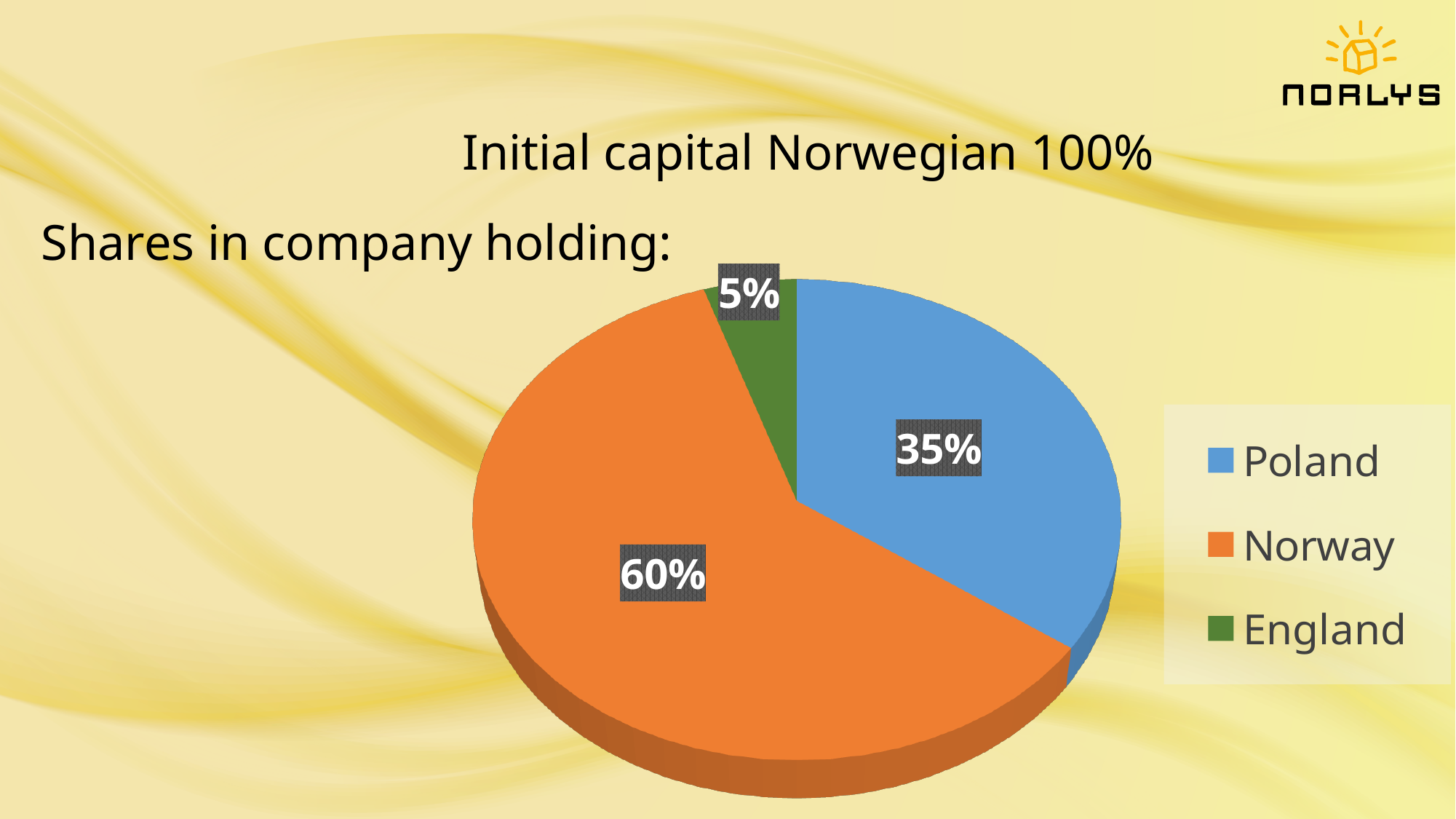
What share of the company holding does Poland have? 35% What share of the company holding does Norway have? 60% Which country holds the largest share in the company holding? Norway What colour represents Norway in the pie chart? Orange How many countries are shown in the pie chart? 3 What is the difference between Poland's share and England's share? 30% What kind of chart is shown on the slide? Pie chart What is the difference between Norway's share and Poland's share? 25% What is the combined share of Poland and England? 40% What share of the company holding does England have? 5% Which has a larger share, Poland or England? Poland Which country holds the smallest share in the company holding? England